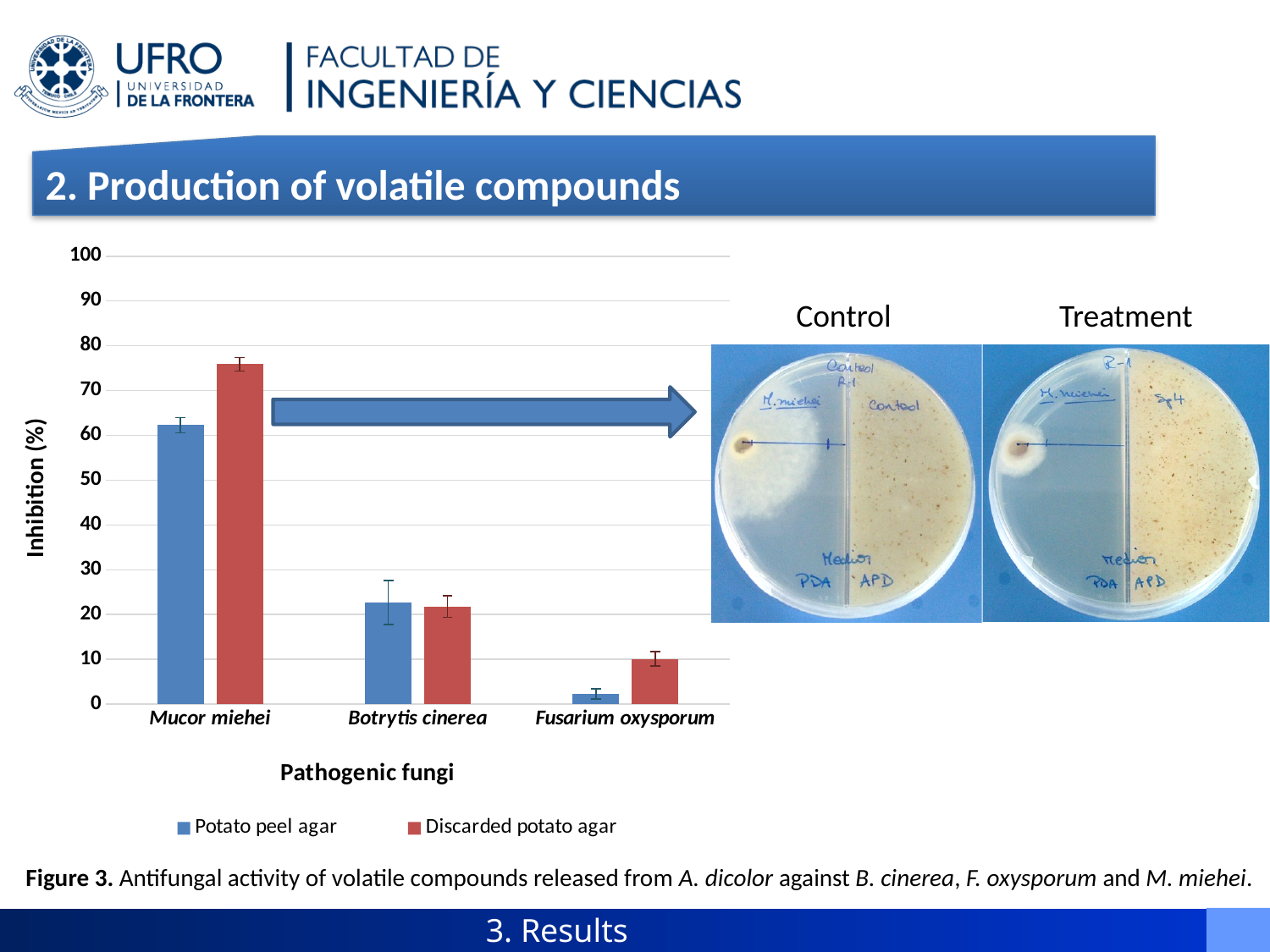
Which colour represents the Discarded potato agar series in the chart? red How many series does the chart legend list? 2 Is the inhibition for Botrytis cinerea on Potato peel agar greater or less than 30? less Which pathogenic fungus has the highest inhibition for Discarded potato agar? Mucor miehei Is the inhibition for Fusarium oxysporum on Discarded potato agar greater or less than 20? less What is the label of the y axis of the chart? Inhibition (%) What kind of chart is shown on the slide? bar chart For Mucor miehei, which series shows the larger inhibition: Potato peel agar or Discarded potato agar? Discarded potato agar How many pathogenic fungi categories are shown on the x axis of the chart? 3 For Fusarium oxysporum, which series shows the larger inhibition: Potato peel agar or Discarded potato agar? Discarded potato agar Which pathogenic fungus has the lowest inhibition for Potato peel agar? Fusarium oxysporum Is the inhibition for Mucor miehei on Discarded potato agar greater or less than 70? greater